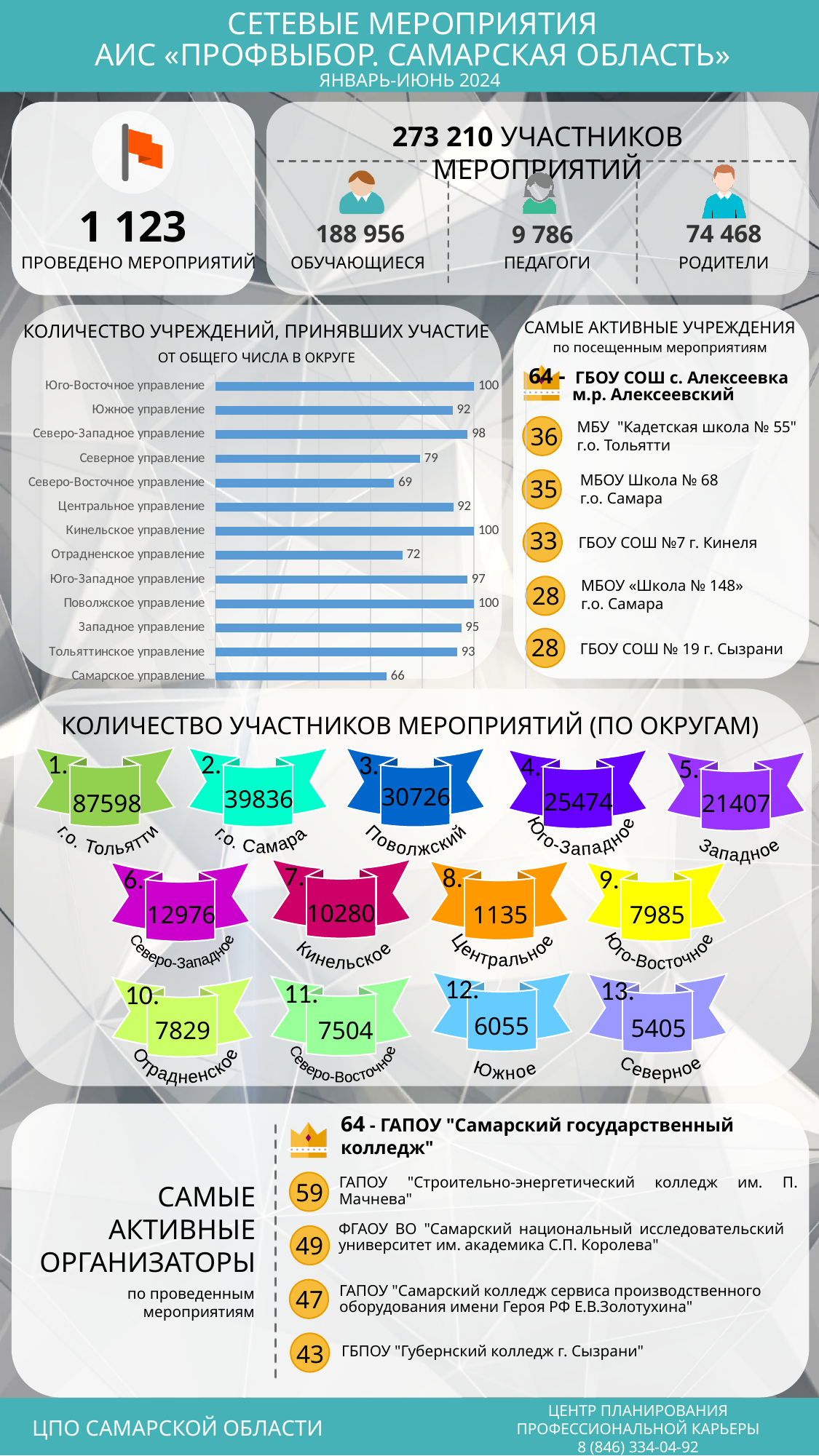
In the bar chart 'Количество учреждений, принявших участие', what is the value for Самарское управление? 66 In the bar chart 'Количество учреждений, принявших участие', what is the value for Северное управление? 79 In the bar chart 'Количество учреждений, принявших участие', which is larger: Отрадненское управление or Северное управление? Северное управление In the bar chart 'Количество учреждений, принявших участие', how many categories have a value of 100? 3 In the bar chart 'Количество учреждений, принявших участие', what is the value for Юго-Западное управление? 97 In the bar chart 'Количество учреждений, принявших участие', which is larger: Северо-Западное управление or Тольяттинское управление? Северо-Западное управление What type of chart is 'Количество учреждений, принявших участие'? bar chart In the bar chart 'Количество учреждений, принявших участие', what is the value for Отрадненское управление? 72 In the bar chart 'Количество учреждений, принявших участие', how many categories are plotted? 13 In the bar chart 'Количество учреждений, принявших участие', which category has the lowest value? Самарское управление In the bar chart 'Количество учреждений, принявших участие', what is the difference between Западное управление and Самарское управление? 29 In the bar chart 'Количество учреждений, принявших участие', what is the difference between Северное управление and Северо-Восточное управление? 10